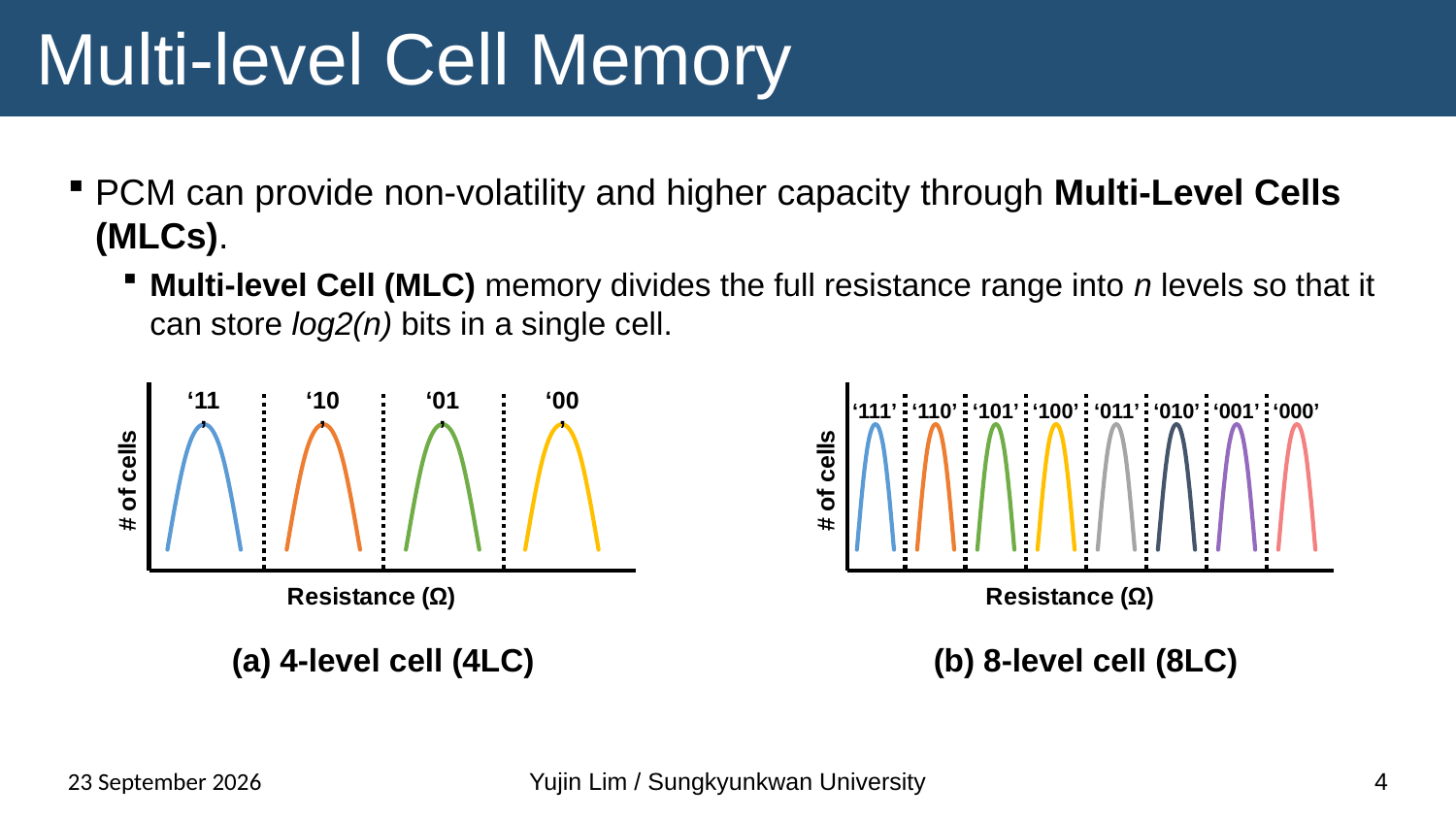
In chart (b) 8-level cell (8LC), how many distribution curves are plotted? 8 In chart (a) 4-level cell (4LC), what colour is the curve labelled '10? Orange In chart (b) 8-level cell (8LC), how many dashed vertical divider lines separate the curves? 7 What kind of chart is chart (a) 4-level cell (4LC)? Line chart In chart (a) 4-level cell (4LC), what is the label of the x axis? Resistance (Ω) In chart (a) 4-level cell (4LC), how many distribution curves are plotted? 4 In chart (b) 8-level cell (8LC), which state label is on the fourth curve from the left? '100' In chart (a) 4-level cell (4LC), which state label is on the rightmost curve? '00' In chart (b) 8-level cell (8LC), what is the label of the y axis? # of cells In chart (b) 8-level cell (8LC), which state label is on the rightmost curve? '000' In chart (b) 8-level cell (8LC), which state label is on the leftmost curve? '111' In chart (a) 4-level cell (4LC), which state label is on the leftmost curve? '11'